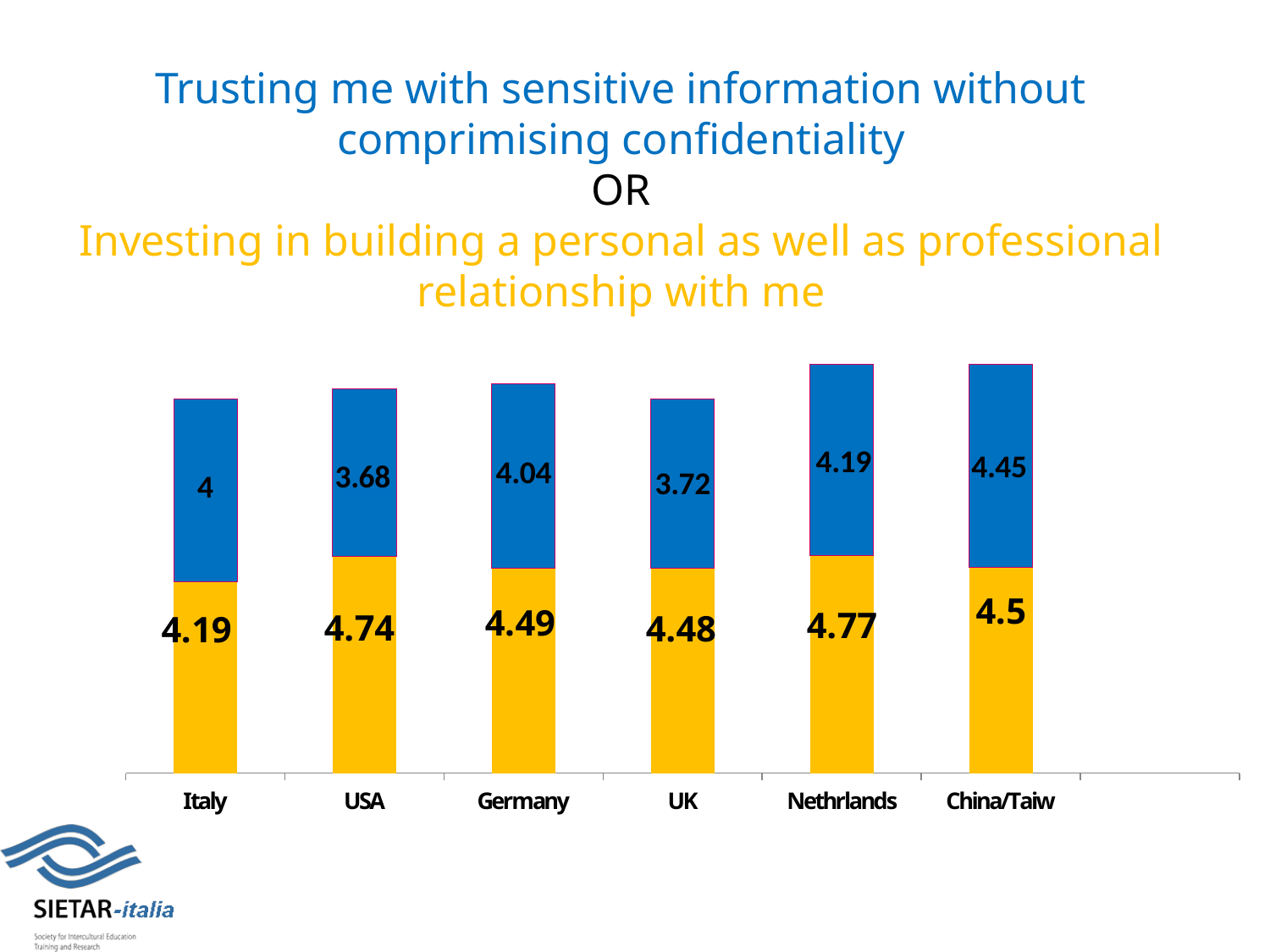
What is the value of the blue segment (Trusting me with sensitive information without comprimising confidentiality) for USA? 3.68 What is the difference between the yellow and blue values for USA? 1.06 How many countries are shown on the x axis? 6 What is the value of the yellow segment (Investing in building a personal as well as professional relationship with me) for Italy? 4.19 Which country has the highest value for the blue segment (Trusting me with sensitive information)? China/Taiw What is the value of the blue segment for China/Taiw? 4.45 Which country has the lowest value for the yellow segment (Investing in building a personal as well as professional relationship)? Italy Is the yellow value for Germany larger or smaller than the yellow value for UK? larger What is the value of the yellow segment for Nethrlands? 4.77 What is the total of the stacked bar for Italy? 8.19 Which country has the lowest value for the blue segment (Trusting me with sensitive information)? USA What kind of chart is shown on the slide? Stacked bar chart